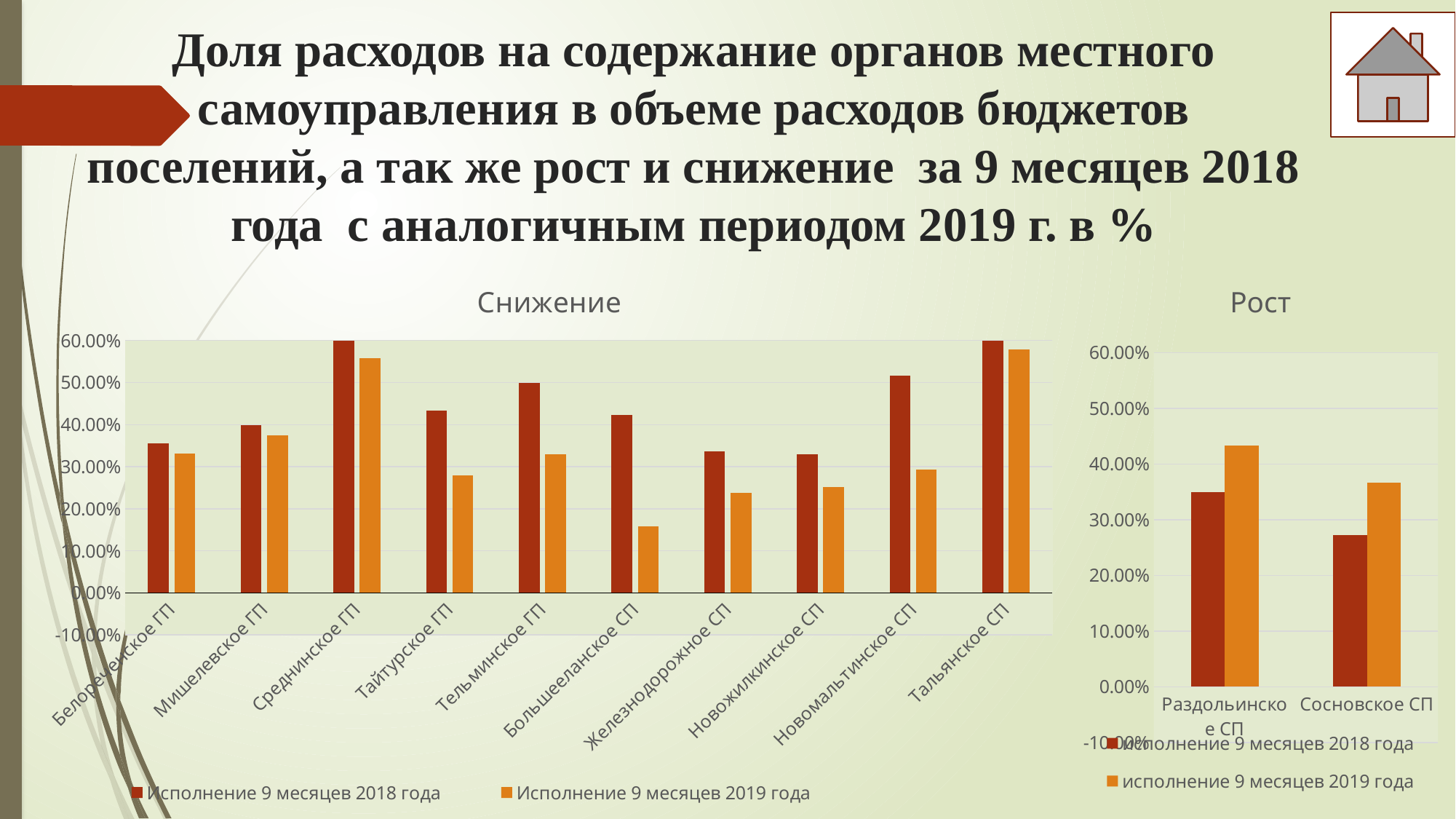
How many categories are shown on the x axis of the "Снижение" chart? 10 In the "Рост" chart, is the value for Сосновское СП in the series "исполнение 9 месяцев 2018 года" greater or less than 30.00%? less In the "Снижение" chart, which is larger for Тайтурское ГП: the 2018 value or the 2019 value? 2018 value What kind of chart is the chart titled "Снижение"? bar chart In the "Снижение" chart, is the value for Тайтурское ГП in the series "Исполнение 9 месяцев 2019 года" greater or less than 30.00%? less In the "Снижение" chart, which category has the lowest value in the series "Исполнение 9 месяцев 2019 года"? Большееланское СП In the "Рост" chart, which category has the higher value in the series "исполнение 9 месяцев 2019 года"? Раздольинское СП In the "Снижение" chart, is the value for Среднинское ГП in the series "Исполнение 9 месяцев 2018 года" greater or less than 50.00%? greater How many categories are shown in the "Рост" chart? 2 What is the title of the chart on the right side of the slide? Рост How many series does the legend of the "Рост" chart list? 2